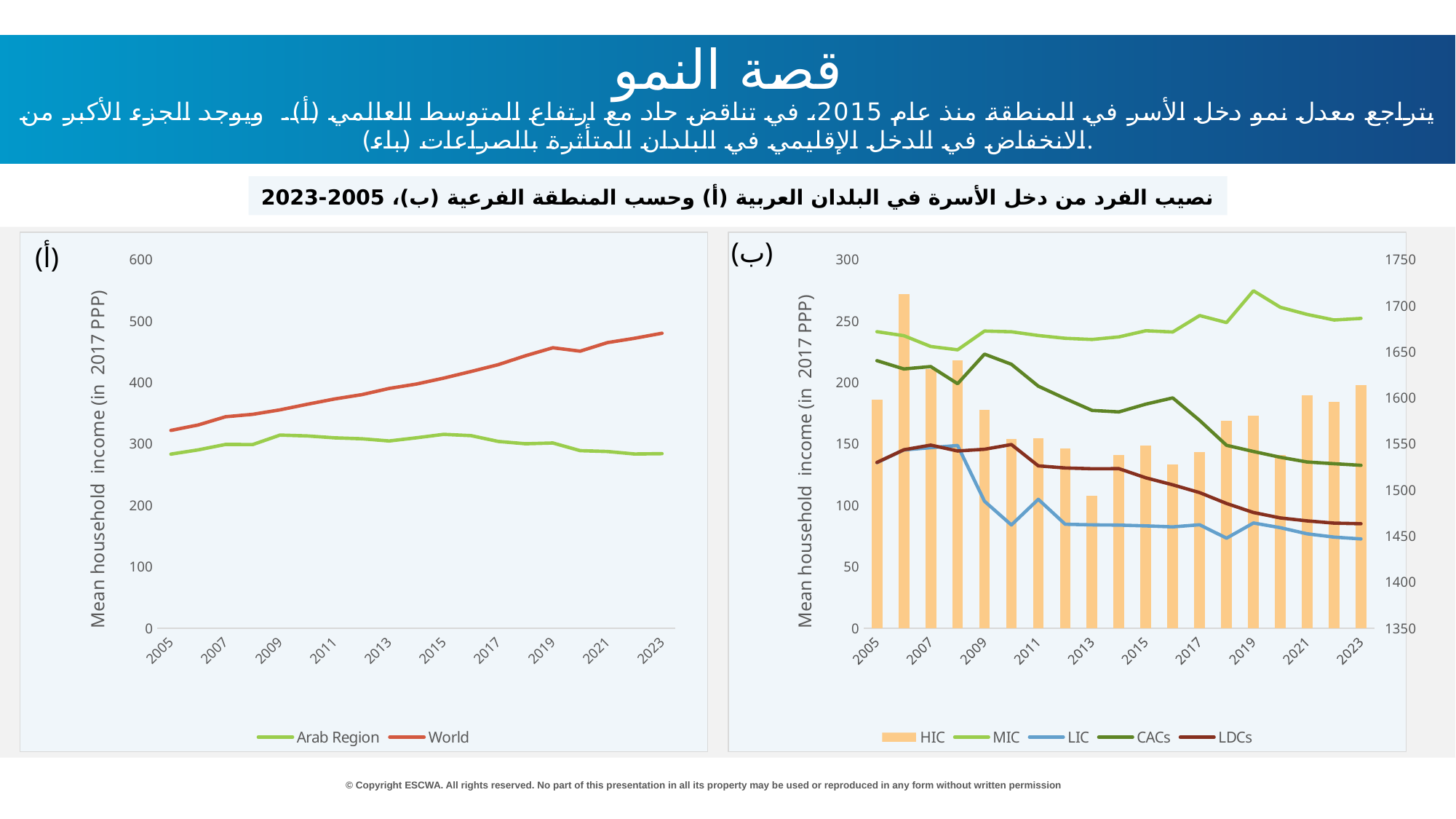
In chart (ب), is the value for LIC in 2023 greater or less than 100? less In chart (ب), is the value for CACs in 2005 greater or less than 200? greater In chart (أ), is the value for World in 2023 greater or less than 400? greater In chart (ب), does the LIC series rise or fall from 2005 to 2023? fall In chart (ب), which series is drawn as bars? HIC In chart (أ), which series has the larger value in 2023, Arab Region or World? World In chart (أ), what type of chart is shown? line chart In chart (أ), what is the label of the vertical axis? Mean household income (in 2017 PPP) In chart (أ), how many series does the legend list? 2 In chart (ب), how many series does the legend list? 5 In chart (أ), does the World series rise or fall from 2005 to 2023? rise